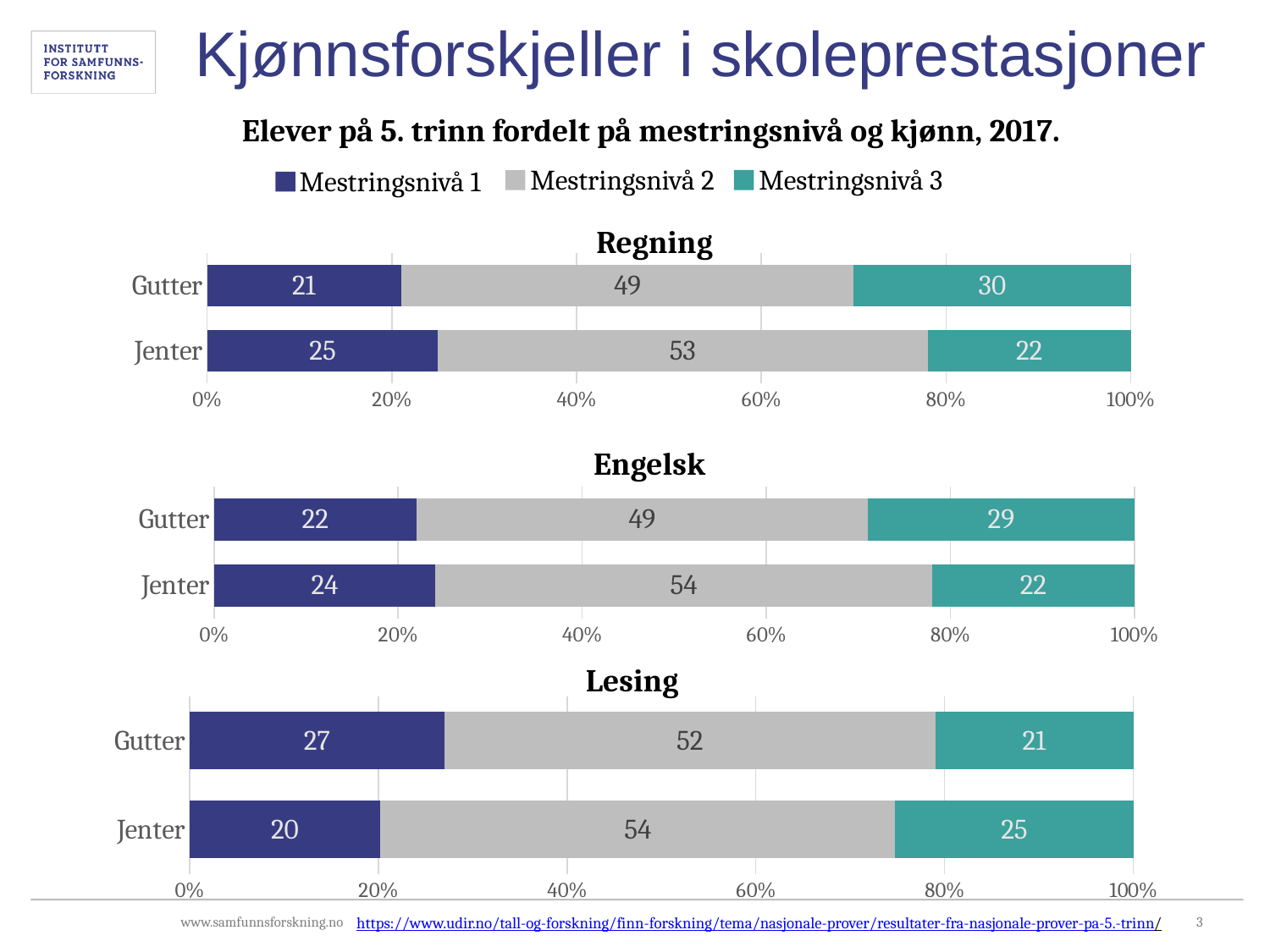
In the Engelsk chart, what is the value for Mestringsnivå 1 for Jenter? 24 How many charts are shown on the slide? 3 In the Regning chart, what is the total of the stacked bar for Gutter? 100 In the Lesing chart, what is the difference between the Mestringsnivå 3 values for Jenter and Gutter? 4 In the Regning chart, what is the value for Mestringsnivå 3 for Gutter? 30 What kind of chart is the Engelsk chart? Stacked bar chart In the Lesing chart, what is the value for Mestringsnivå 1 for Gutter? 27 In the Regning chart, what is the value for Mestringsnivå 2 for Jenter? 53 In the Lesing chart, which category has the lower Mestringsnivå 1 value? Jenter In the Regning chart, which is larger: the Mestringsnivå 3 value for Gutter or for Jenter? Gutter How many series does the legend list? 3 In the Engelsk chart, which category has the higher Mestringsnivå 2 value? Jenter